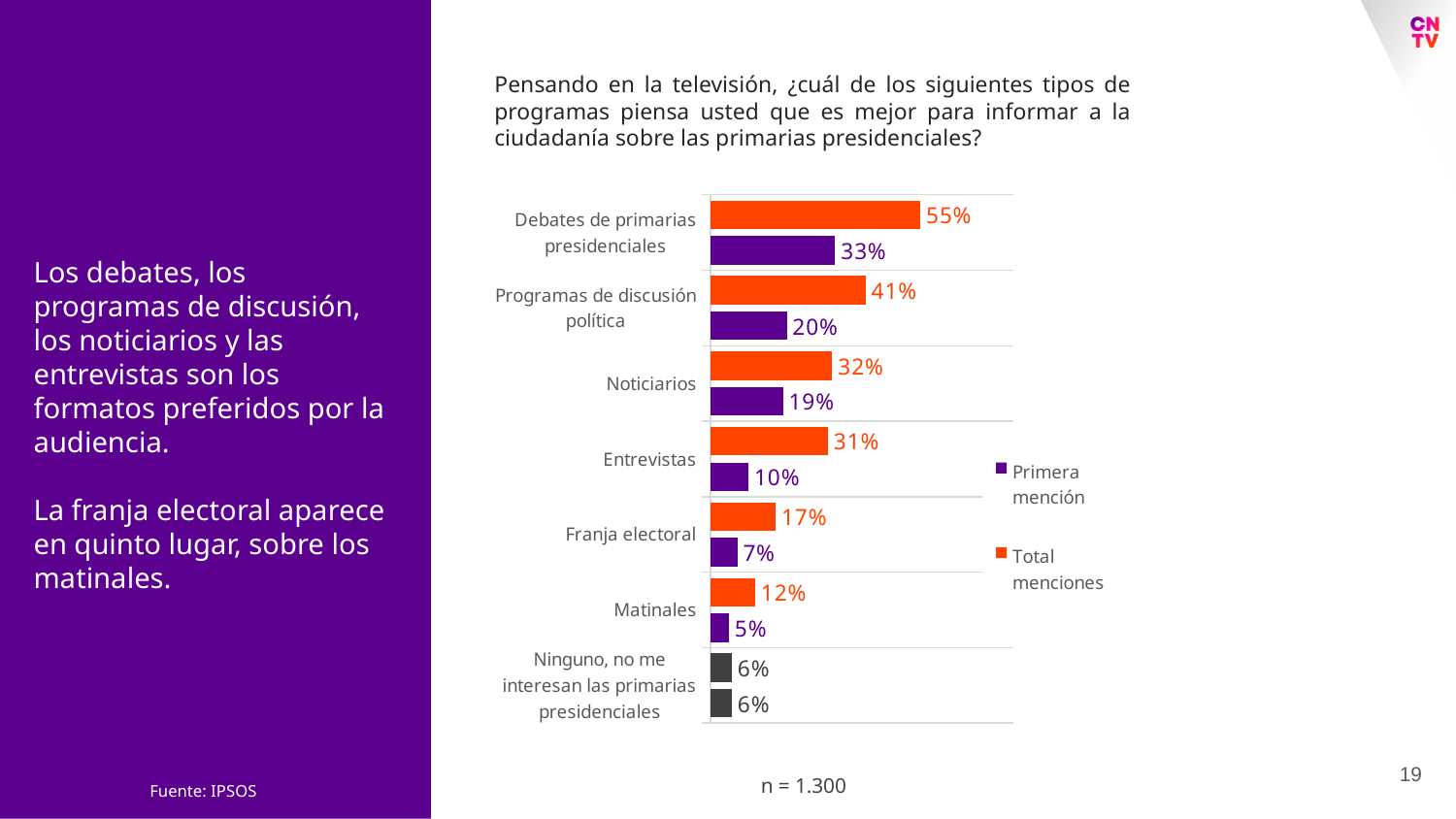
Which is larger: the 'Total menciones' value for Matinales or for Franja electoral? Franja electoral What is the sample size (n) shown below the chart? n = 1.300 What is the 'Total menciones' value for Entrevistas? 31% How many series does the legend list? 2 How many categories are shown in the chart? 7 Which category has the highest 'Total menciones' value? Debates de primarias presidenciales What is the difference between the 'Total menciones' and 'Primera mención' values for Programas de discusión política? 21% What is the 'Primera mención' value for Noticiarios? 19% What is the 'Primera mención' value for Franja electoral? 7% Which category has the lowest 'Primera mención' value? Matinales What type of chart is shown on the slide? Bar chart What is the 'Total menciones' value for Debates de primarias presidenciales? 55%